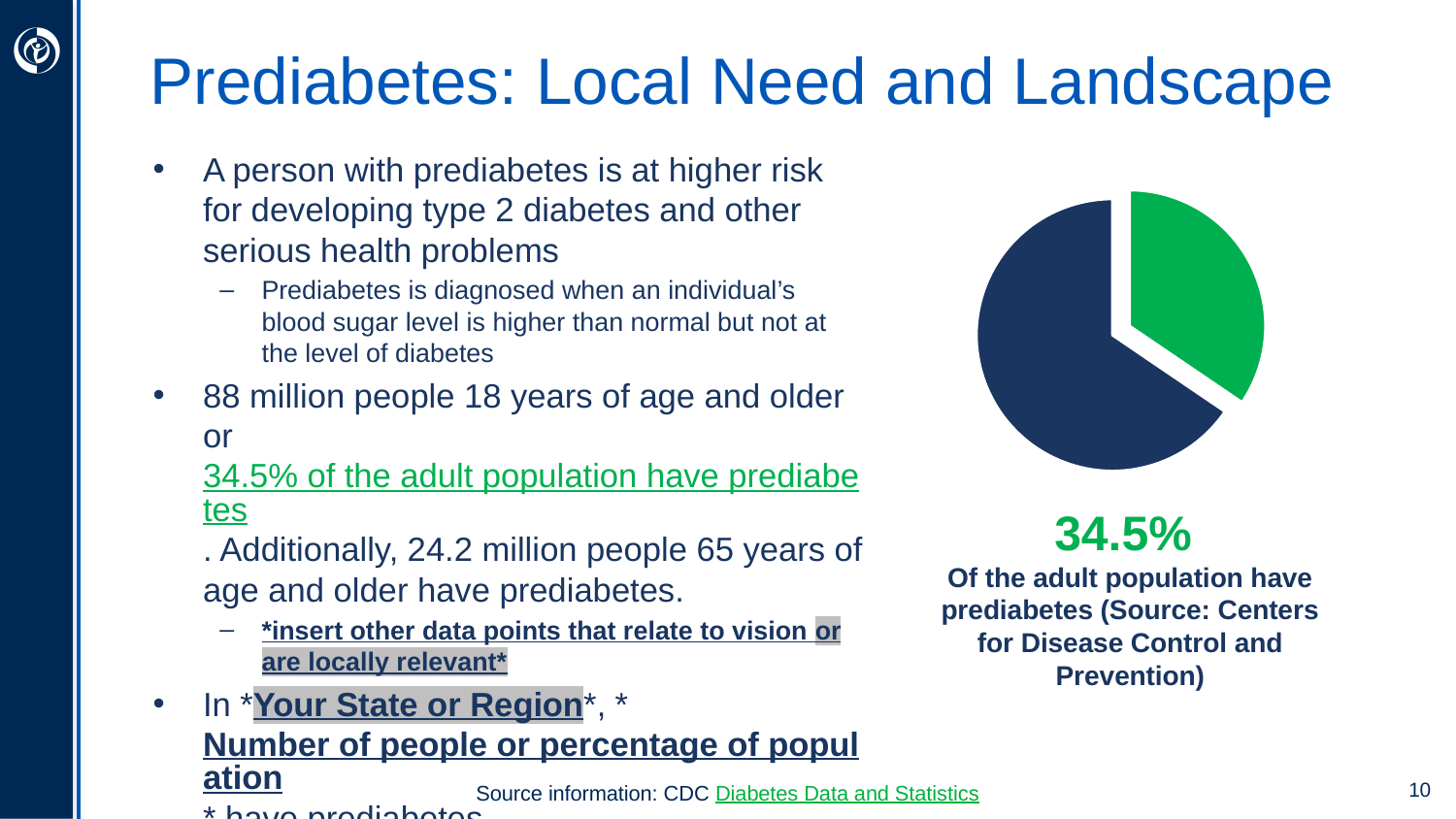
What share of the pie does the green slice represent? 34.5% How many slices does the pie chart have? 2 According to the caption under the pie chart, what does the 34.5% figure represent? Of the adult population have prediabetes Which slice of the pie chart is the largest? the dark navy slice Which slice of the pie chart is larger, the green slice or the dark navy slice? the dark navy slice What percentage is printed in large bold text beneath the pie chart? 34.5% Which slice of the pie chart is the smallest? the green slice Which slice of the pie chart is pulled out (exploded) from the rest of the pie? the green slice What kind of chart is shown on the slide? pie chart